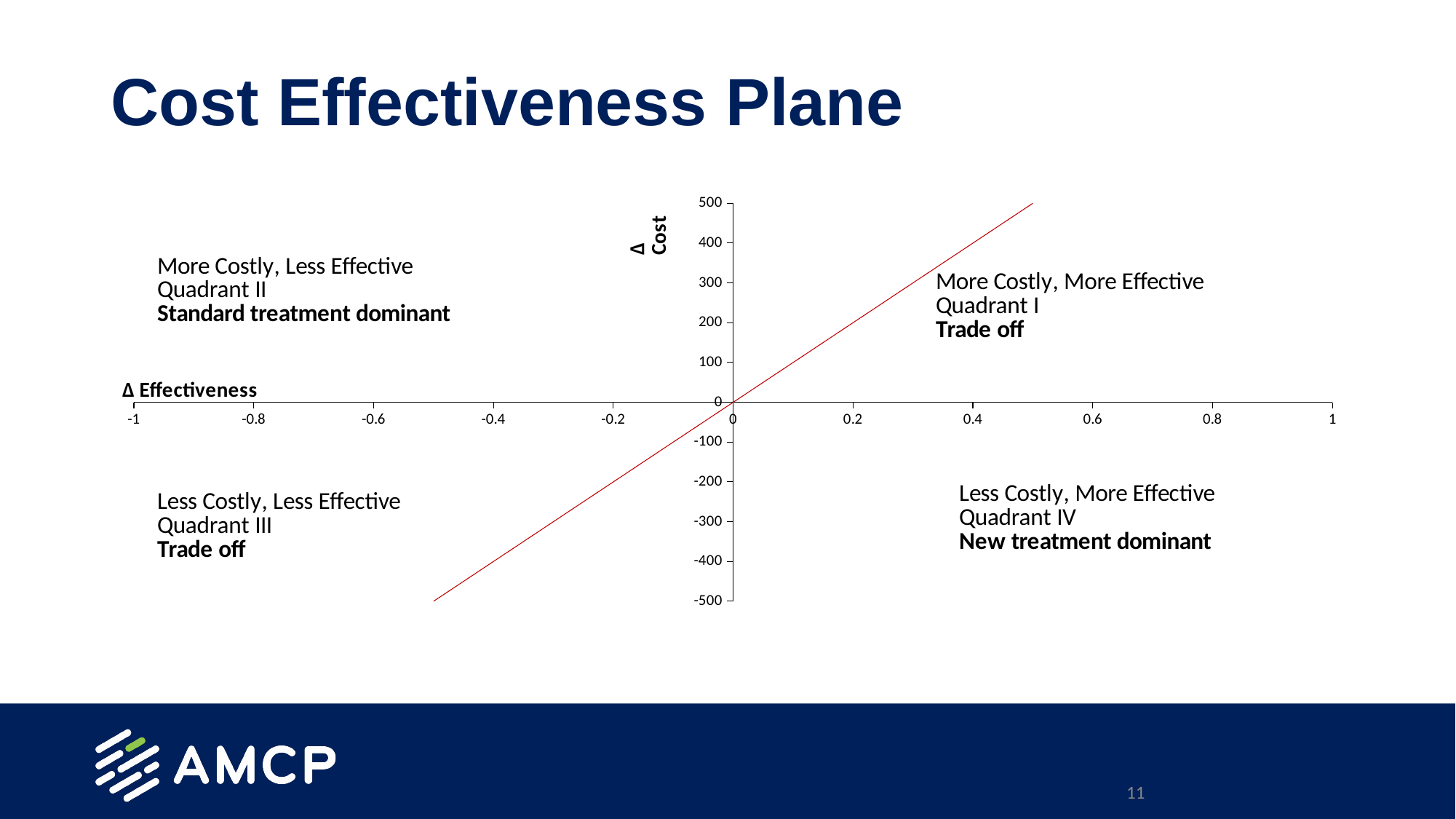
Does the red line rise or fall as Δ Effectiveness increases from left to right? rises At Δ Effectiveness of -0.2, is the Δ Cost value on the red line greater or less than -100? less Which quadrant is labelled "New treatment dominant"? Quadrant IV How many quadrants are labelled on the chart? 4 At Δ Effectiveness of 0.4, is the Δ Cost value on the red line greater or less than 300? greater What kind of chart is shown on the slide? line chart At Δ Effectiveness of -0.4, is the Δ Cost value on the red line greater or less than -300? less What is the label of the vertical axis of the chart? Δ Cost